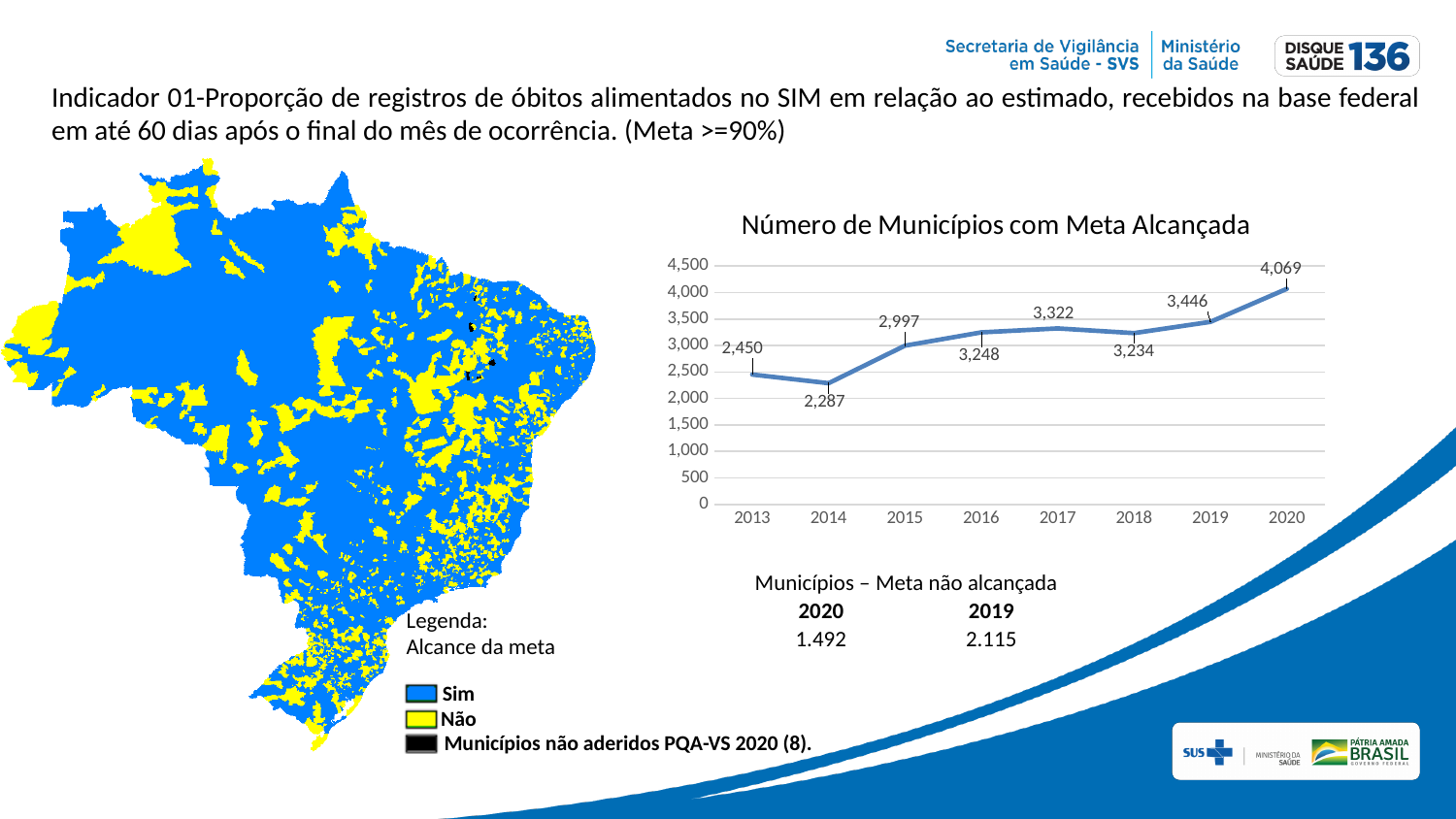
How many years are plotted in the chart 'Número de Municípios com Meta Alcançada'? 8 In the chart 'Número de Municípios com Meta Alcançada', which is larger, the value for 2016 or the value for 2018? 2016 In the chart 'Número de Municípios com Meta Alcançada', do the values generally rise or fall from 2014 to 2020? rise In the chart 'Número de Municípios com Meta Alcançada', what is the difference between the values for 2020 and 2019? 623 In the chart 'Número de Municípios com Meta Alcançada', what is the value for 2013? 2,450 In the chart 'Número de Municípios com Meta Alcançada', which year has the highest value? 2020 In the chart 'Número de Municípios com Meta Alcançada', which year has the lowest value? 2014 In the chart 'Número de Municípios com Meta Alcançada', is the value for 2019 greater or less than 3,000? greater In the chart 'Número de Municípios com Meta Alcançada', what is the difference between the values for 2015 and 2014? 710 What type of chart is 'Número de Municípios com Meta Alcançada'? line chart In the chart 'Número de Municípios com Meta Alcançada', what is the value for 2017? 3,322 In the chart 'Número de Municípios com Meta Alcançada', what is the value for 2020? 4,069